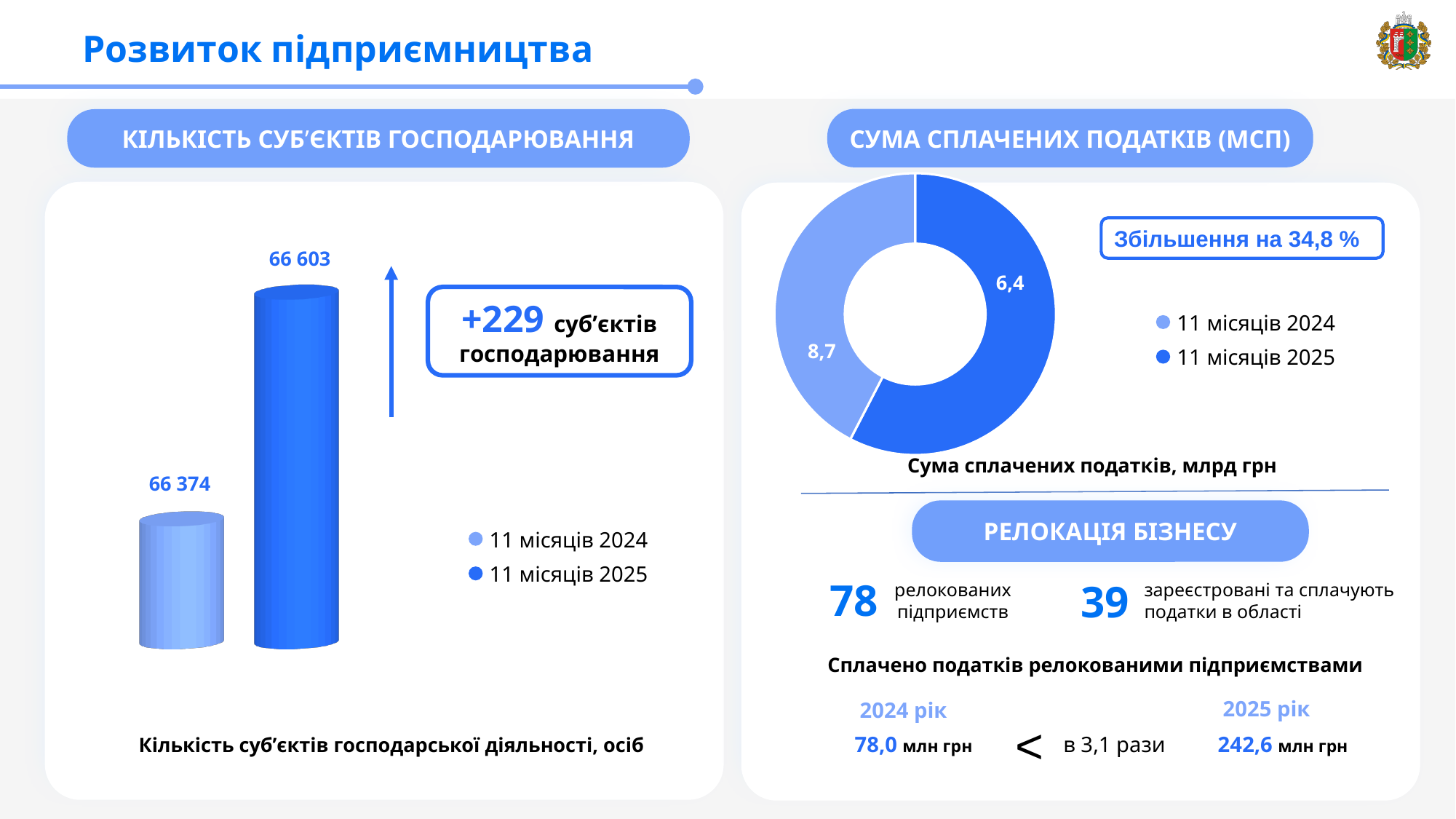
On the left chart (Кількість суб'єктів господарської діяльності, осіб), what is the value for 11 місяців 2024? 66 374 On the left chart (Кількість суб'єктів господарської діяльності, осіб), does the value rise or fall from 2024 to 2025? Rise On the left chart (Кількість суб'єктів господарської діяльності, осіб), which period has the lower value? 11 місяців 2024 On the left chart (Кількість суб'єктів господарської діяльності, осіб), what is the difference between the 2025 and 2024 values? 229 On the right chart (Сума сплачених податків, млрд грн), what kind of chart is shown? Doughnut chart On the right chart (Сума сплачених податків, млрд грн), what are the two values printed on the slices? 8,7 and 6,4 On the left chart (Кількість суб'єктів господарської діяльності, осіб), which period has the higher value? 11 місяців 2025 On the left chart (Кількість суб'єктів господарської діяльності, осіб), what is the value for 11 місяців 2025? 66 603 On the left chart (Кількість суб'єктів господарської діяльності, осіб), how many bars are plotted? 2 On the right chart (Сума сплачених податків, млрд грн), how many entries does the legend list? 2 On the right chart (Сума сплачених податків, млрд грн), what is the total of the two labelled values? 15,1 On the left chart (Кількість суб'єктів господарської діяльності, осіб), what kind of chart is shown? Bar chart